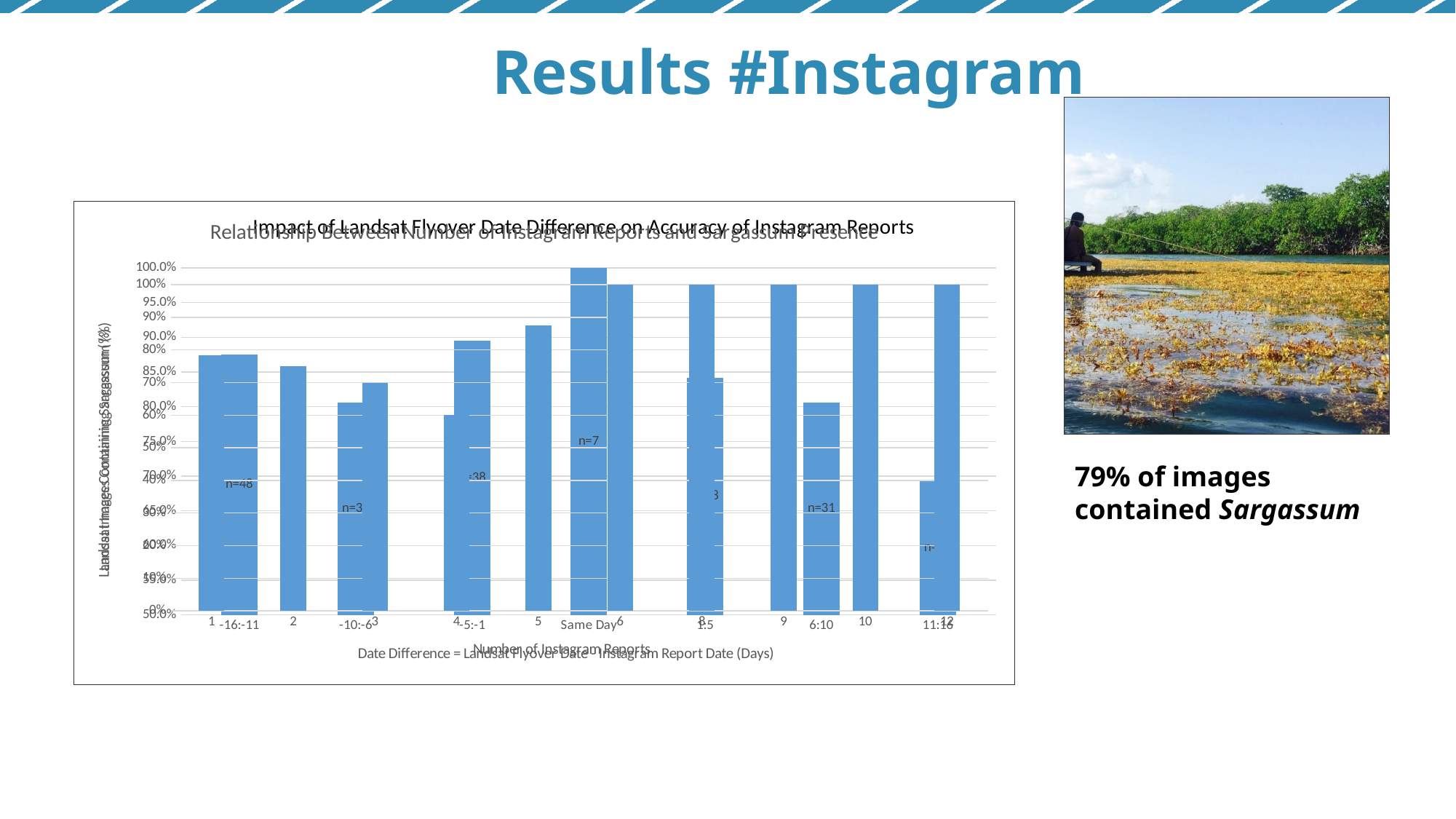
In the chart titled 'Relationship Between Number of Instagram Reports and Sargassum Presence', how many categories are shown on the x axis? 10 In the chart titled 'Relationship Between Number of Instagram Reports and Sargassum Presence', what is the x-axis label? Number of Instagram Reports In the chart titled 'Impact of Landsat Flyover Date Difference on Accuracy of Instagram Reports', what sample-size label is printed on the '6:10' bar? n=31 In the chart titled 'Impact of Landsat Flyover Date Difference on Accuracy of Instagram Reports', what sample-size label is printed on the 'Same Day' bar? n=7 In the chart titled 'Impact of Landsat Flyover Date Difference on Accuracy of Instagram Reports', what is the x-axis label? Date Difference = Landsat Flyover Date - Instagram Report Date (Days) What kind of chart is shown on the slide? bar chart In the chart titled 'Impact of Landsat Flyover Date Difference on Accuracy of Instagram Reports', how many date-difference categories are shown on the x axis? 7